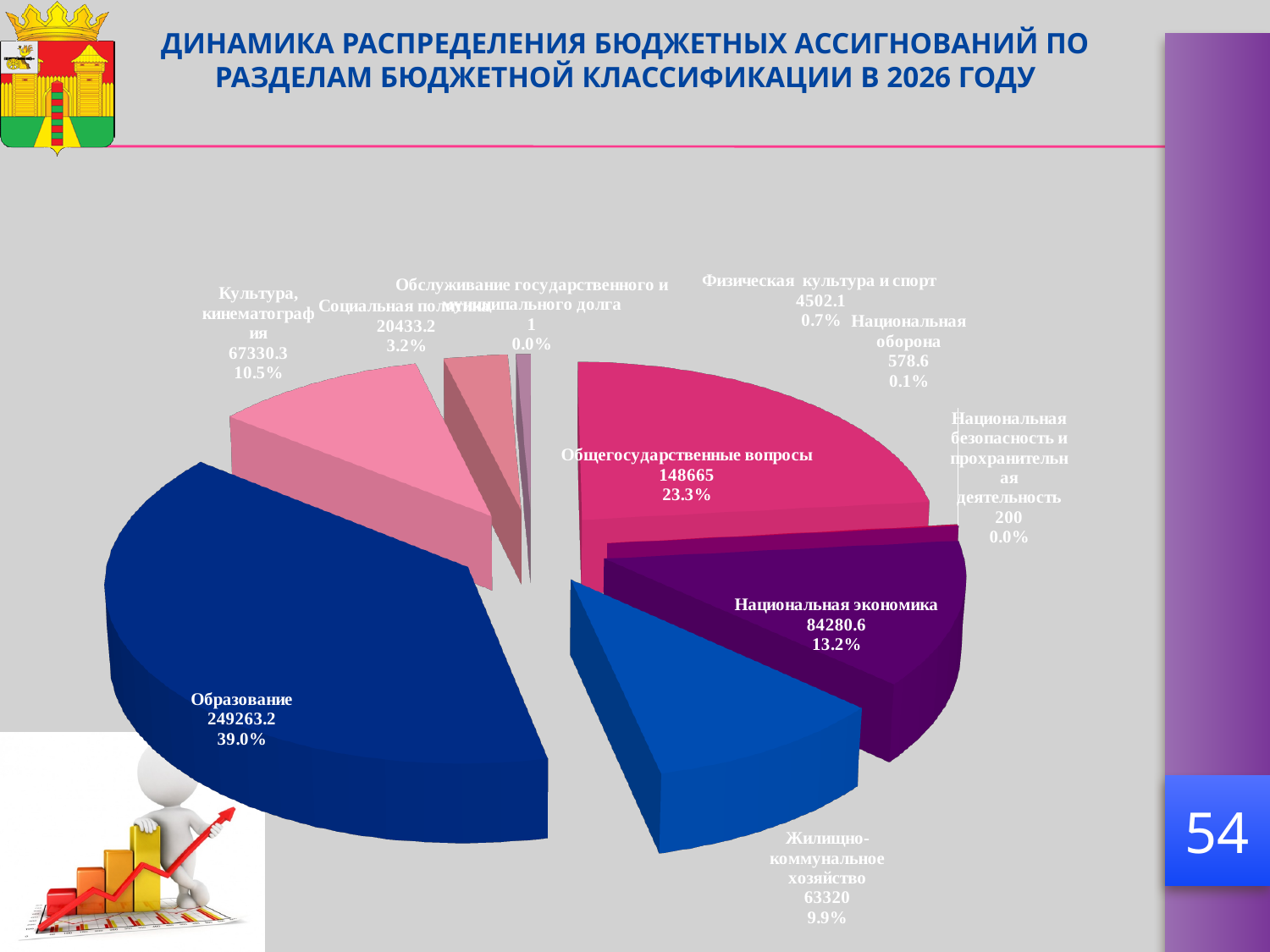
What is the value shown for Образование? 249263.2 Which category has the largest slice of the pie? Образование What is the value shown for Физическая культура и спорт? 4502.1 What year does the chart title refer to? 2026 What is the value shown for Национальная экономика? 84280.6 Which is larger: Культура, кинематография or Жилищно-коммунальное хозяйство? Культура, кинематография Which category has the smallest value in the chart? Обслуживание государственного и муниципального долга What percentage is shown for Жилищно-коммунальное хозяйство? 9.9% What is the difference between the values for Общегосударственные вопросы and Национальная экономика? 64384.4 What share of the pie does Общегосударственные вопросы represent? 23.3% How many categories are shown in the pie chart? 10 What kind of chart is shown on the slide? Pie chart